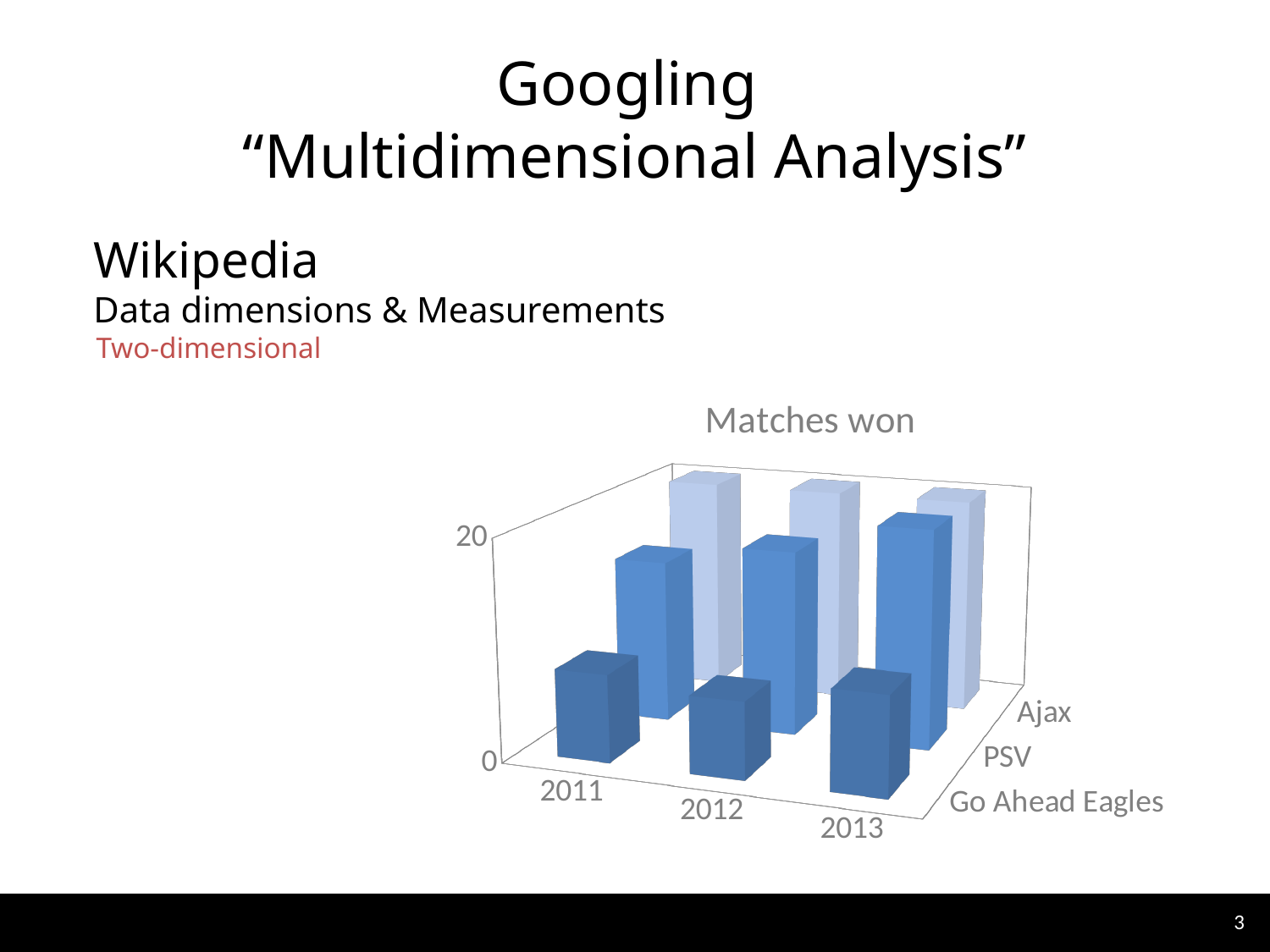
Which is larger in 2011: the value for Ajax or the value for Go Ahead Eagles? Ajax What is the title of the chart? Matches won Is the value for Go Ahead Eagles in 2013 greater or less than 20? less How many teams are shown in the chart? 3 Is the value for Go Ahead Eagles in 2011 greater or less than 20? less Which team has the highest bars in the chart? Ajax What kind of chart is shown on the slide? bar chart How many years are shown along the x axis of the chart? 3 Which is larger in 2012: the value for PSV or the value for Go Ahead Eagles? PSV Which team has the lowest bars in the chart? Go Ahead Eagles Which team is listed at the back of the depth axis of the chart? Ajax